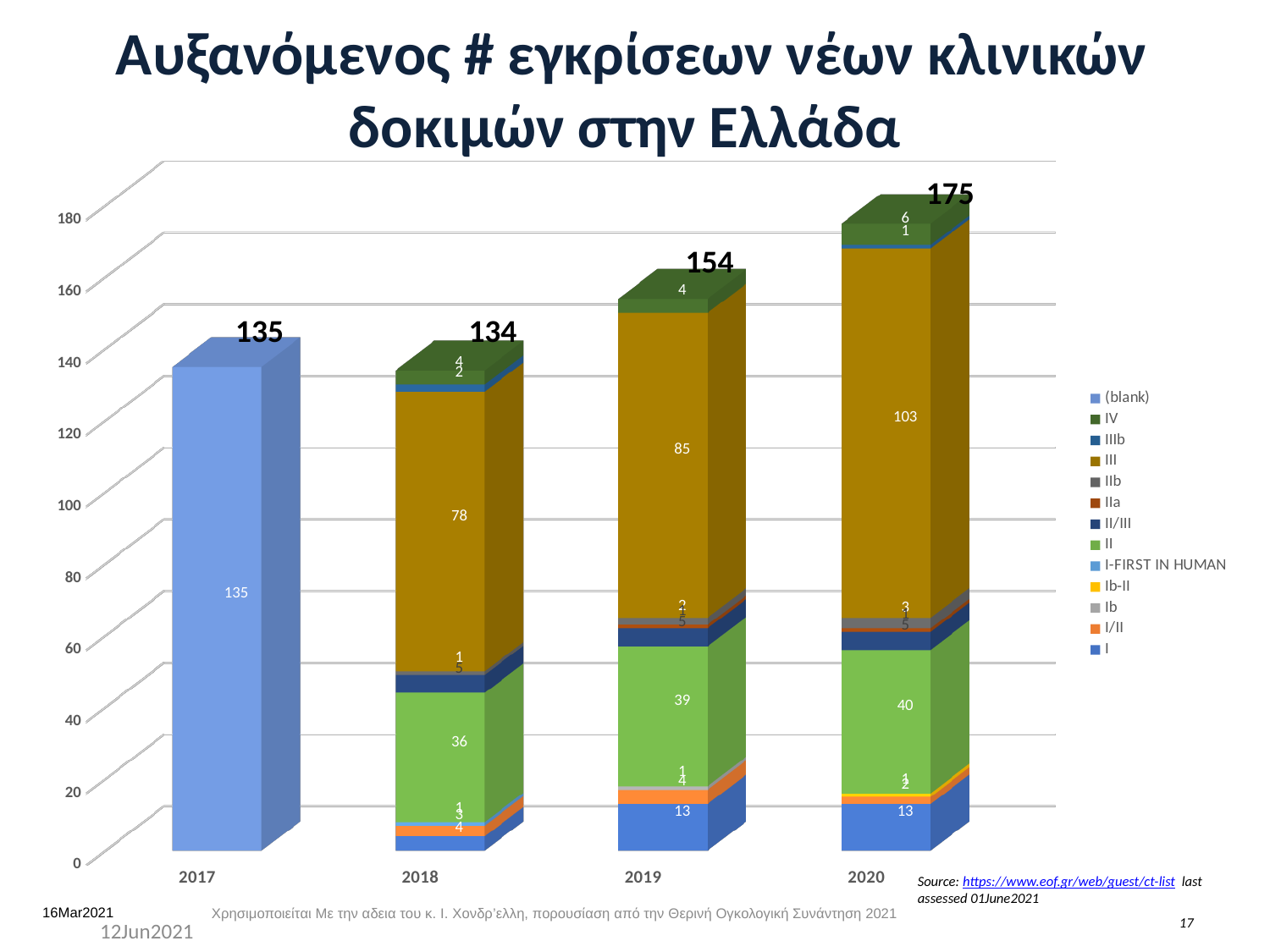
What is the total number of approvals shown for 2020? 175 How many series does the legend list? 13 Do the bar totals rise or fall from 2018 to 2020? Rise Which year has the lowest total number of approvals? 2018 What is the difference between the totals for 2020 and 2019? 21 What kind of chart is shown on the slide? Stacked bar chart Which year has the larger III segment, 2018 or 2019? 2019 Which year has the highest total number of approvals? 2020 How many years are shown on the x axis? 4 What is the value of the IV segment in the 2020 bar? 6 What is the value of the II segment in the 2019 bar? 39 What is the value of the III segment in the 2020 bar? 103